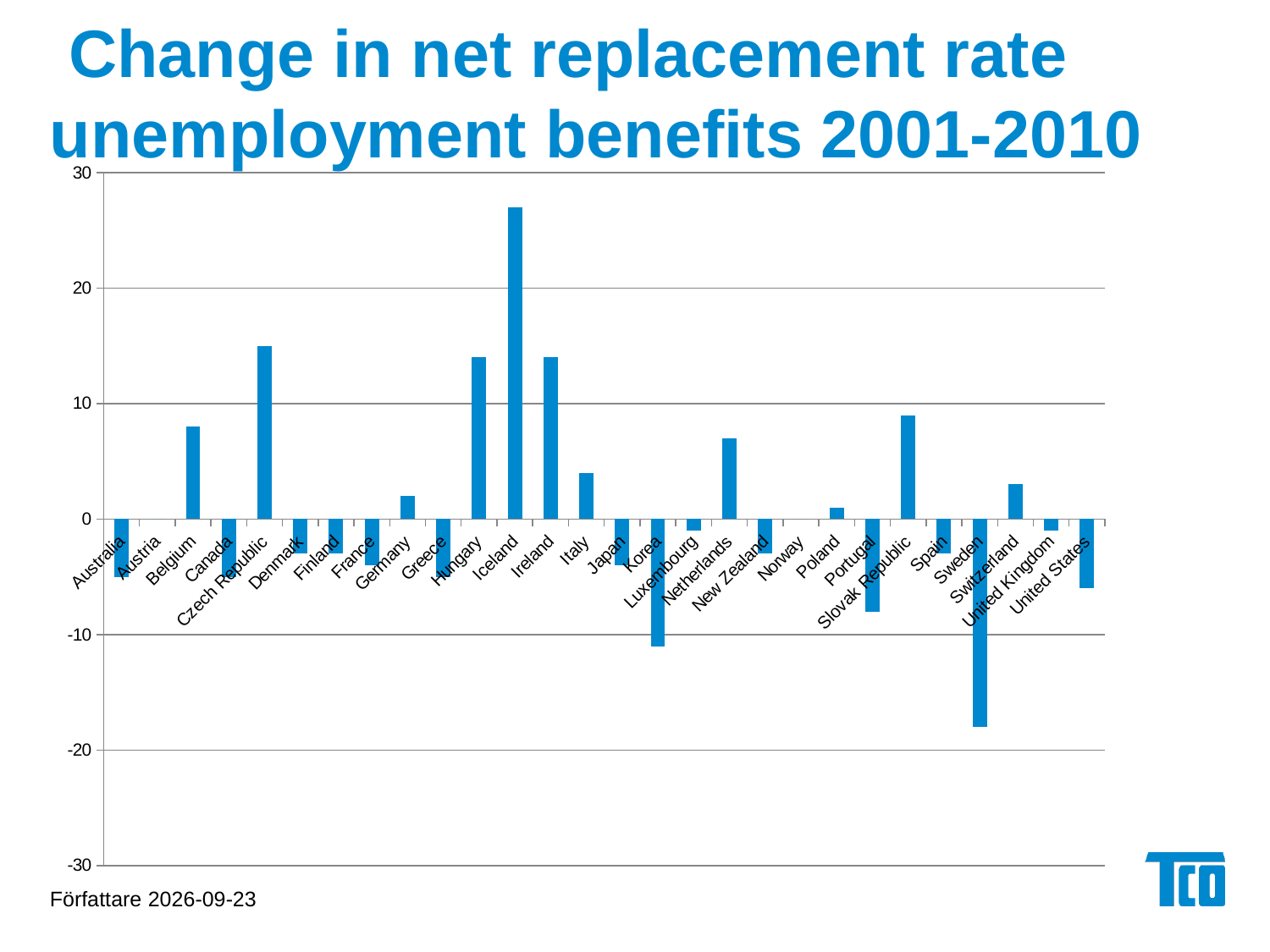
How many countries are shown on the x axis of the chart? 28 Is the value for Portugal greater or less than -10? greater Is the value for Belgium greater or less than 10? less Which has the larger value, Iceland or Czech Republic? Iceland Which has the lower value, Korea or Portugal? Korea Which country has the lowest change in net replacement rate? Sweden What is the title of the chart? Change in net replacement rate unemployment benefits 2001-2010 Which country has the highest change in net replacement rate? Iceland Is the value for Czech Republic greater or less than 10? greater What kind of chart is shown on the slide? bar chart